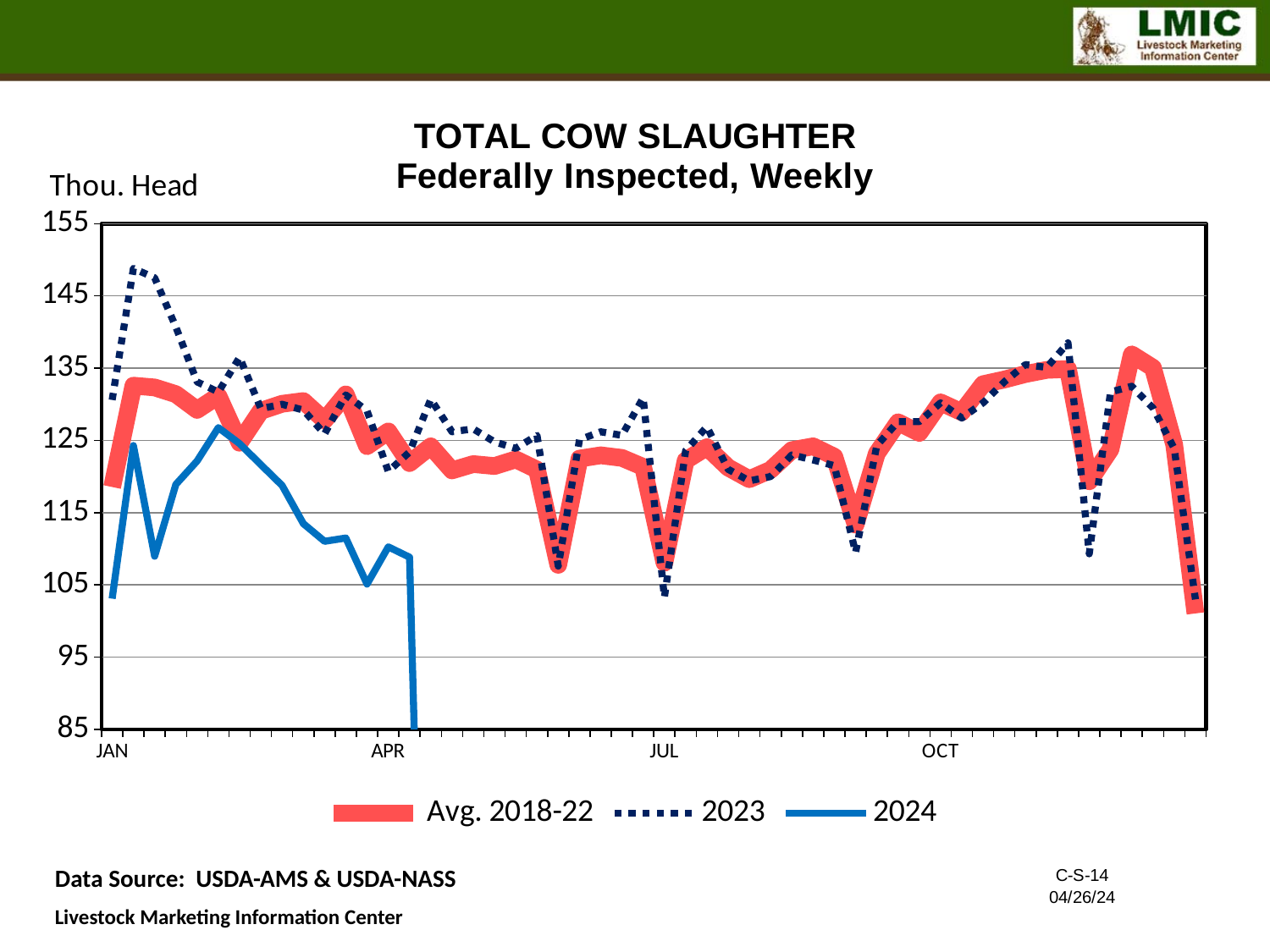
How many series does the legend list? 3 What unit is shown on the vertical axis of the chart? Thou. Head What kind of chart is shown on the slide? line chart Is the peak value of the 2023 series in January greater or less than 145? greater What is the title of the chart? TOTAL COW SLAUGHTER Federally Inspected, Weekly In January, which series is higher: 2023 or 2024? 2023 Does the 2024 series rise or fall from its February peak to April? fall Is the value of the 2024 series in March greater or less than 115? less Is the peak value of the 2024 series in February greater or less than 115? greater Which series reaches the highest value in January: Avg. 2018-22, 2023, or 2024? 2023